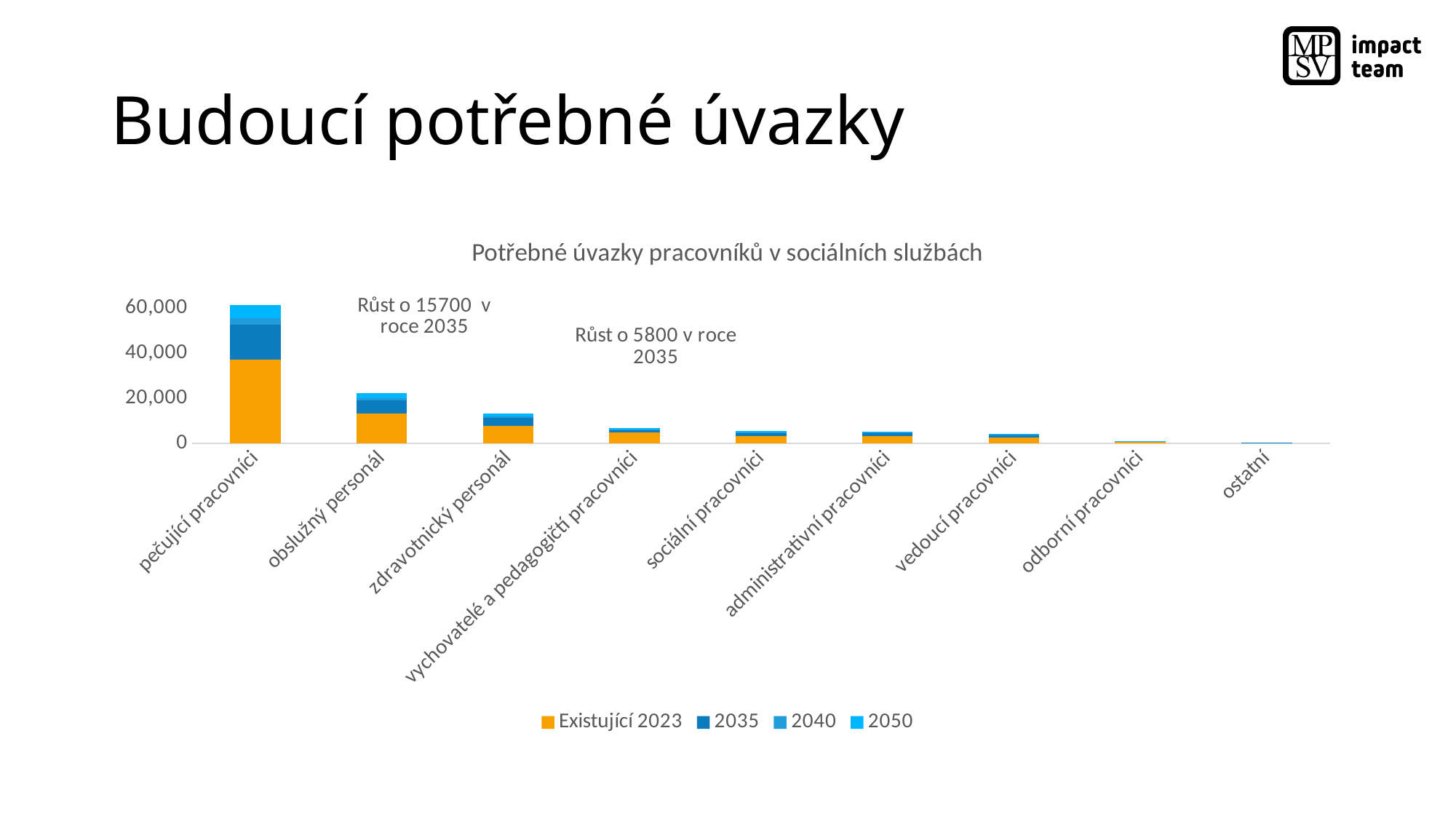
What is the title of the chart? Potřebné úvazky pracovníků v sociálních službách Which category has the highest total stacked bar? pečující pracovníci Do the total stacked values rise or fall moving from left to right along the x axis? fall Which series is shown in orange in the chart legend? Existující 2023 Which category has the lowest total stacked bar? ostatní How many series does the chart legend list? 4 Is the total stacked value for pečující pracovníci greater or less than 40,000? greater How many categories are shown on the x axis of the chart? 9 Is the total stacked value for zdravotnický personál greater or less than 20,000? less Which has a larger total stacked bar, obslužný personál or zdravotnický personál? obslužný personál What kind of chart is shown on the slide? stacked bar chart Is the Existující 2023 value for pečující pracovníci greater or less than 40,000? less